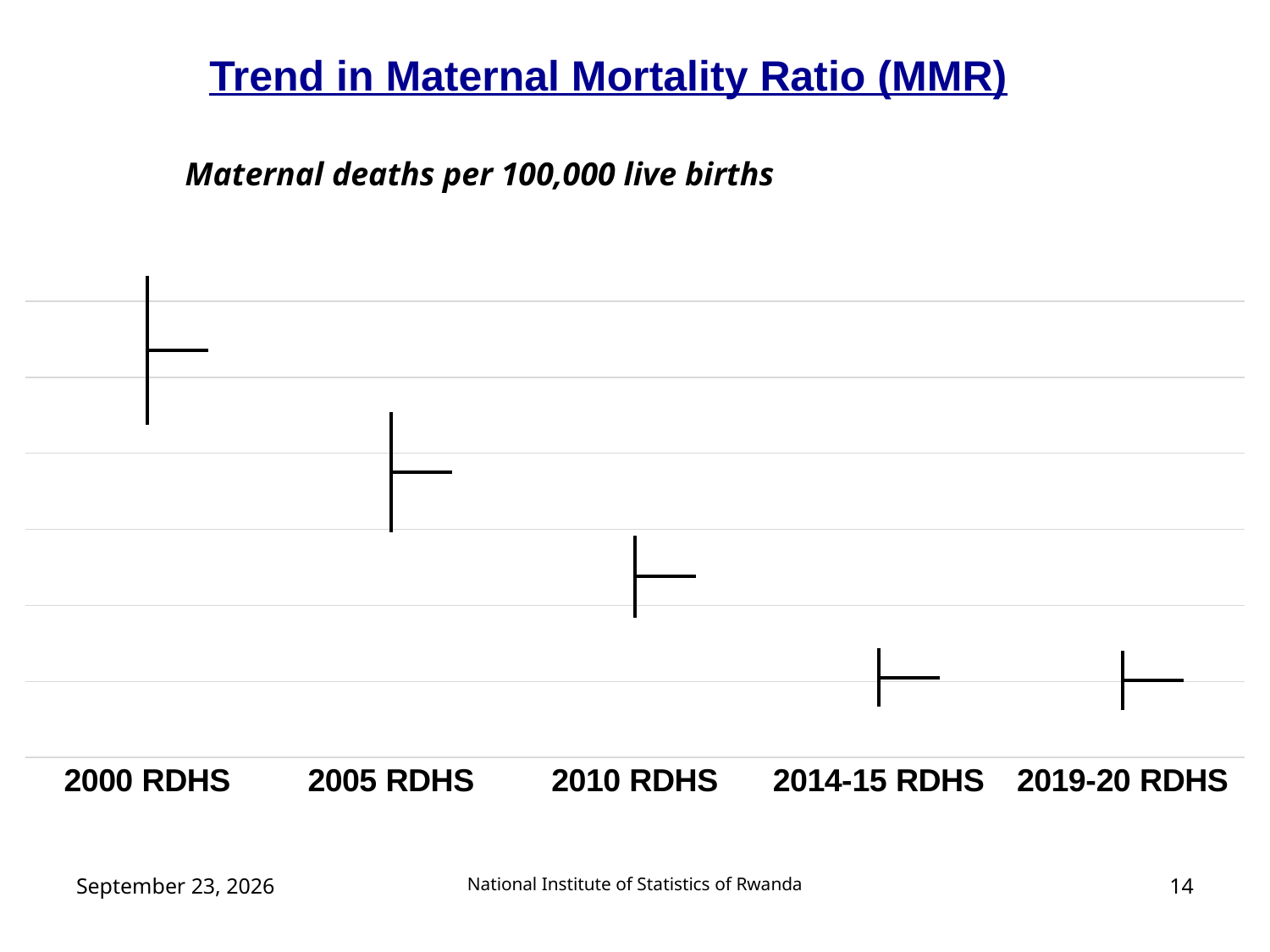
Do the maternal mortality ratio values rise or fall from 2000 RDHS to 2019-20 RDHS? fall Which survey round shows the highest maternal mortality ratio? 2000 RDHS What is the label of the first category on the x axis? 2000 RDHS Which has the larger maternal mortality ratio, 2010 RDHS or 2019-20 RDHS? 2010 RDHS How many survey rounds (categories) are shown on the x axis of the chart? 5 Which has the larger maternal mortality ratio, 2000 RDHS or 2010 RDHS? 2000 RDHS What is the title printed above the chart? Maternal deaths per 100,000 live births Which has the larger maternal mortality ratio, 2005 RDHS or 2014-15 RDHS? 2005 RDHS